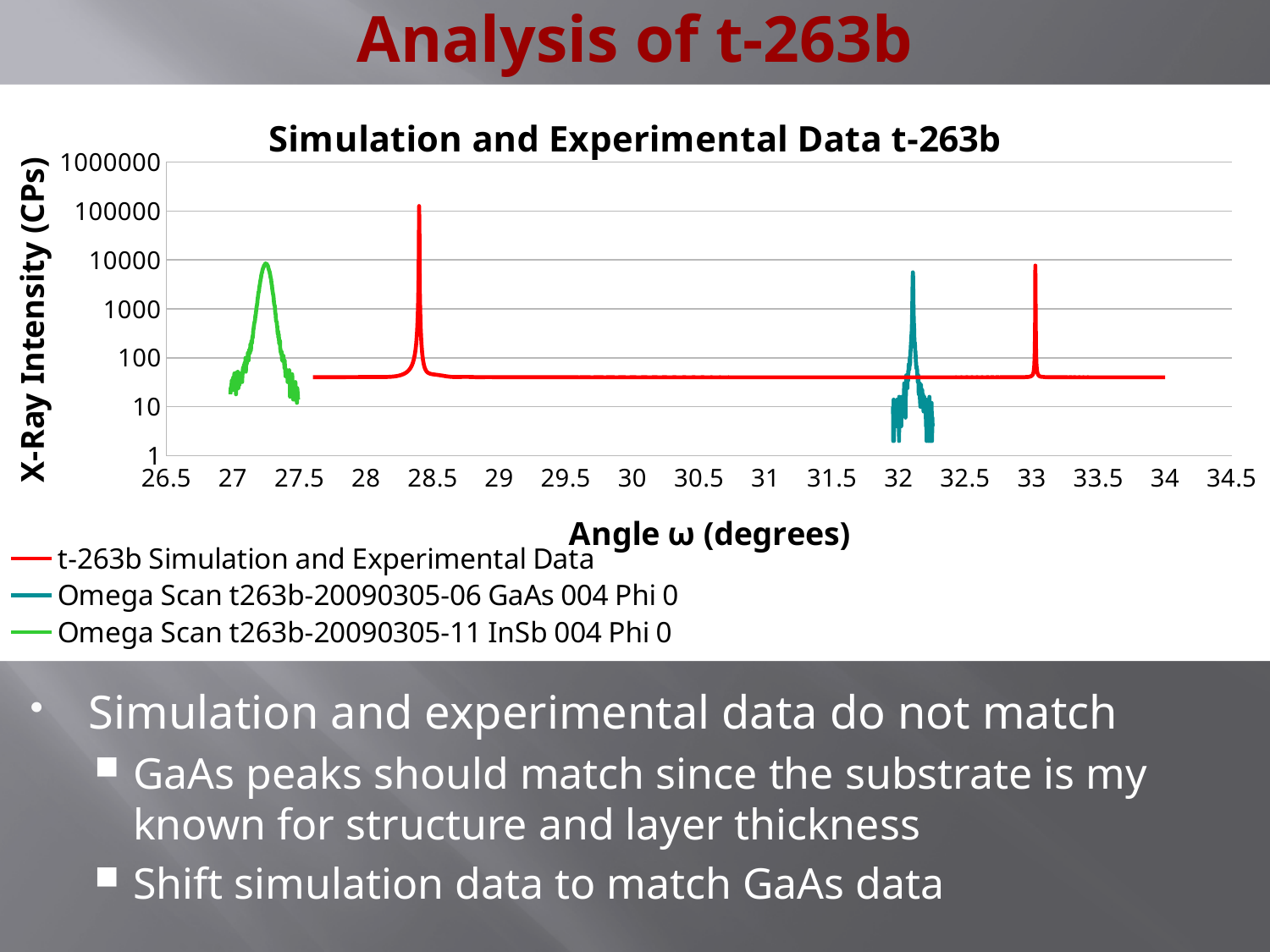
Is the peak of the Omega Scan t263b-20090305-06 GaAs 004 Phi 0 series greater or less than 10000 CPs? less Which series reaches the highest X-Ray Intensity on the chart? t-263b Simulation and Experimental Data Is the angle of the Omega Scan t263b-20090305-06 GaAs 004 Phi 0 peak greater or less than 32.5 degrees? less How many series does the legend list? 3 Which is higher: the peak of the t-263b Simulation and Experimental Data series or the peak of the Omega Scan t263b-20090305-11 InSb 004 Phi 0 series? t-263b Simulation and Experimental Data Is the highest peak of the t-263b Simulation and Experimental Data series greater or less than 10000 CPs? greater Which series has its peak at the lowest angle ω? Omega Scan t263b-20090305-11 InSb 004 Phi 0 What is the title of the chart? Simulation and Experimental Data t-263b What is the label of the y axis? X-Ray Intensity (CPs) What kind of chart is shown on the slide? line chart